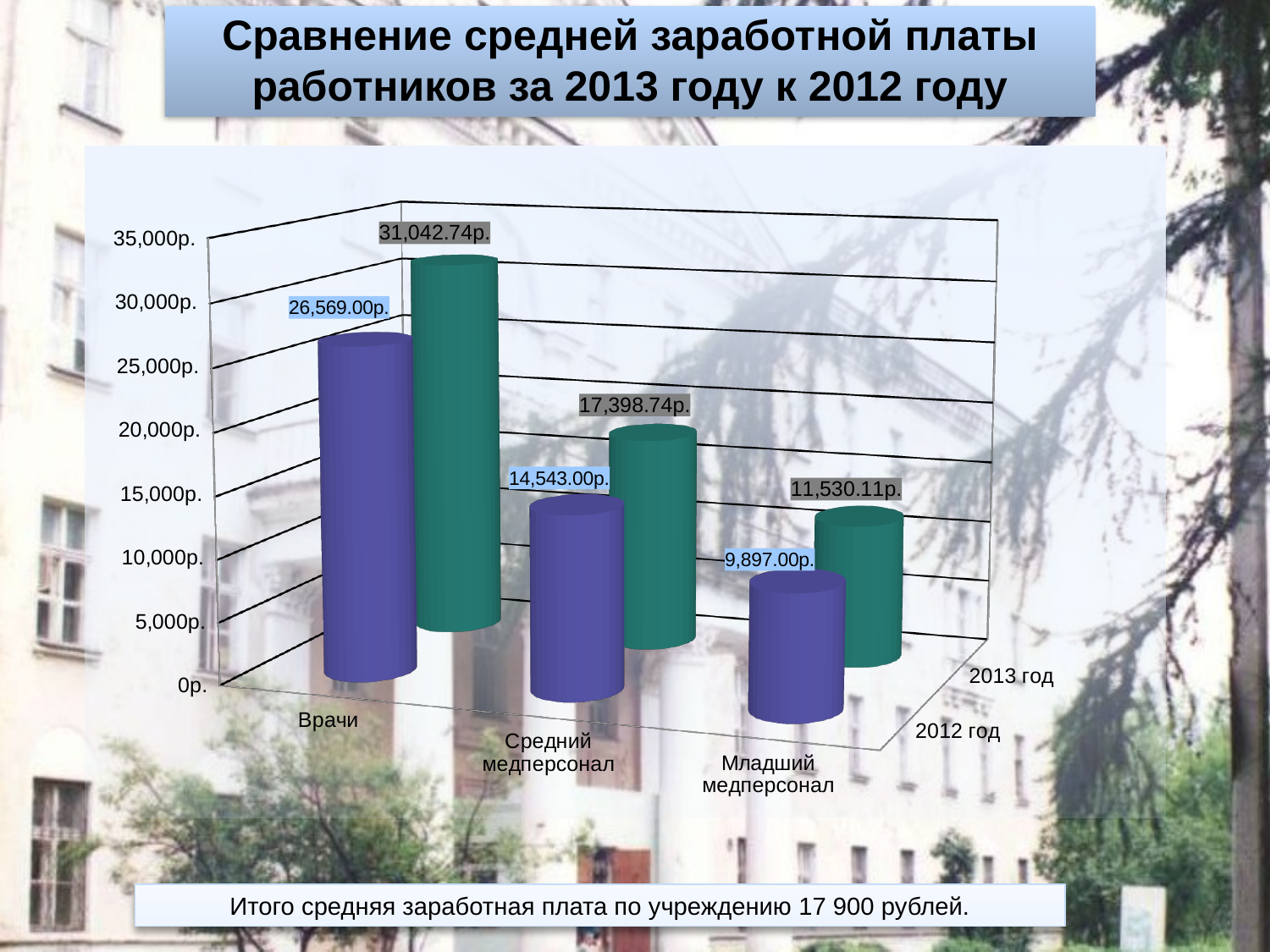
Which category has the highest average salary in 2013 год? Врачи What was the average salary of Врачи in 2012 год? 26,569.00р. By how much did the average salary of Врачи increase from 2012 год to 2013 год? 4,473.74р. Which category has the lowest average salary in 2012 год? Младший медперсонал What was the average salary of Младший медперсонал in 2012 год? 9,897.00р. What was the average salary of Врачи in 2013 год? 31,042.74р. Which is larger: the 2013 год salary of Средний медперсонал or the 2012 год salary of Врачи? 2012 год salary of Врачи What was the average salary of Средний медперсонал in 2013 год? 17,398.74р. What is the difference between the 2013 год and 2012 год average salary for Младший медперсонал? 1,633.11р. How many data series (years) does the chart show? 2 How many employee categories are shown on the chart? 3 What type of chart is shown on the slide? Bar chart